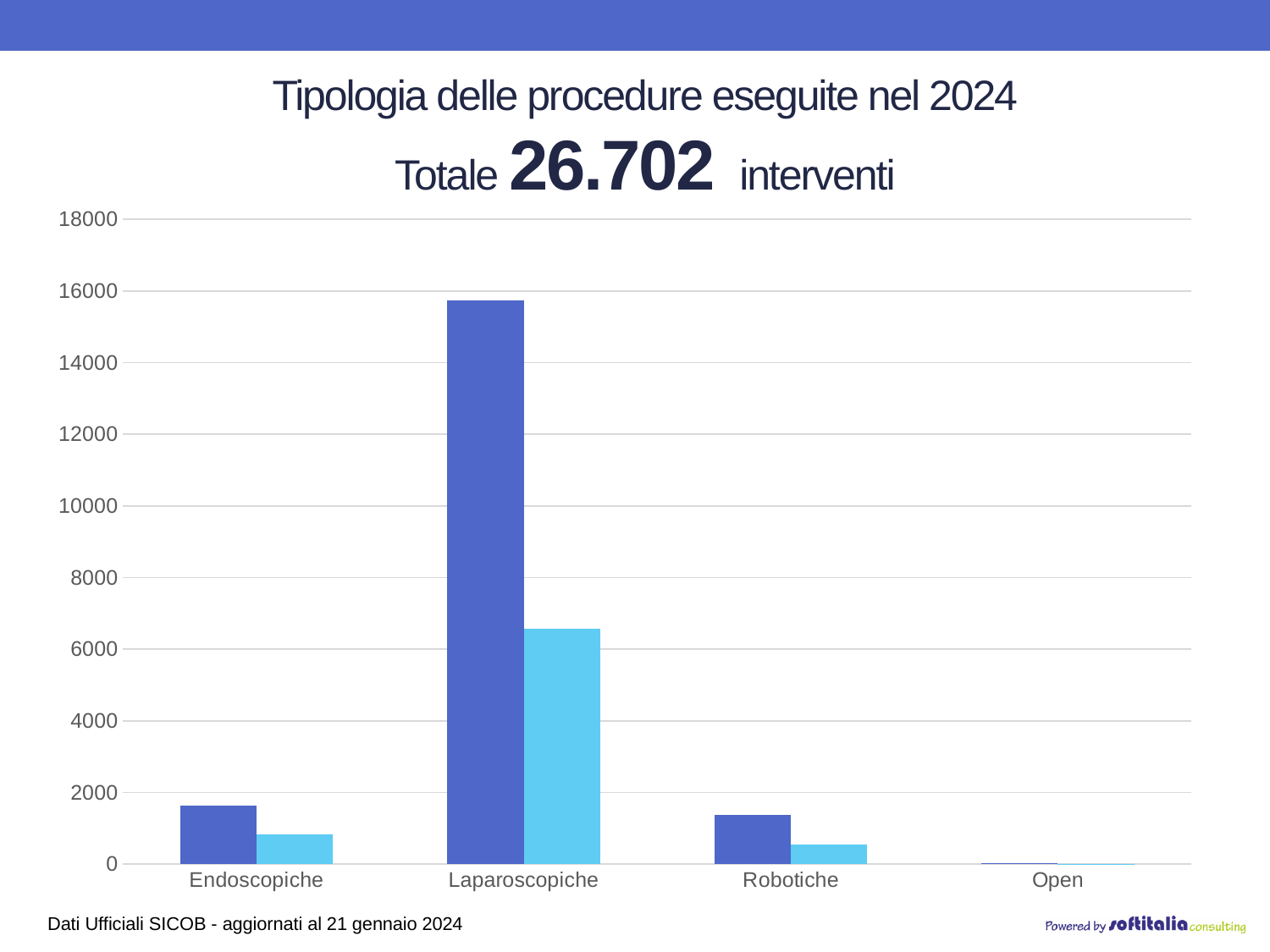
Is the value of the light blue bar for Laparoscopiche greater or less than 6000? greater What kind of chart is shown on the slide? bar chart Which category has the lowest bars in the chart? Open How many categories are shown on the x axis of the chart? 4 What total number of interventions is stated in the chart title? 26.702 Is the value of the dark blue bar for Endoscopiche greater or less than 2000? less Is the value of the dark blue bar for Robotiche greater or less than 2000? less For Laparoscopiche, which bar is taller, the dark blue one or the light blue one? the dark blue one Which category has the tallest bar in the chart? Laparoscopiche Which light blue bar is taller, Endoscopiche or Robotiche? Endoscopiche